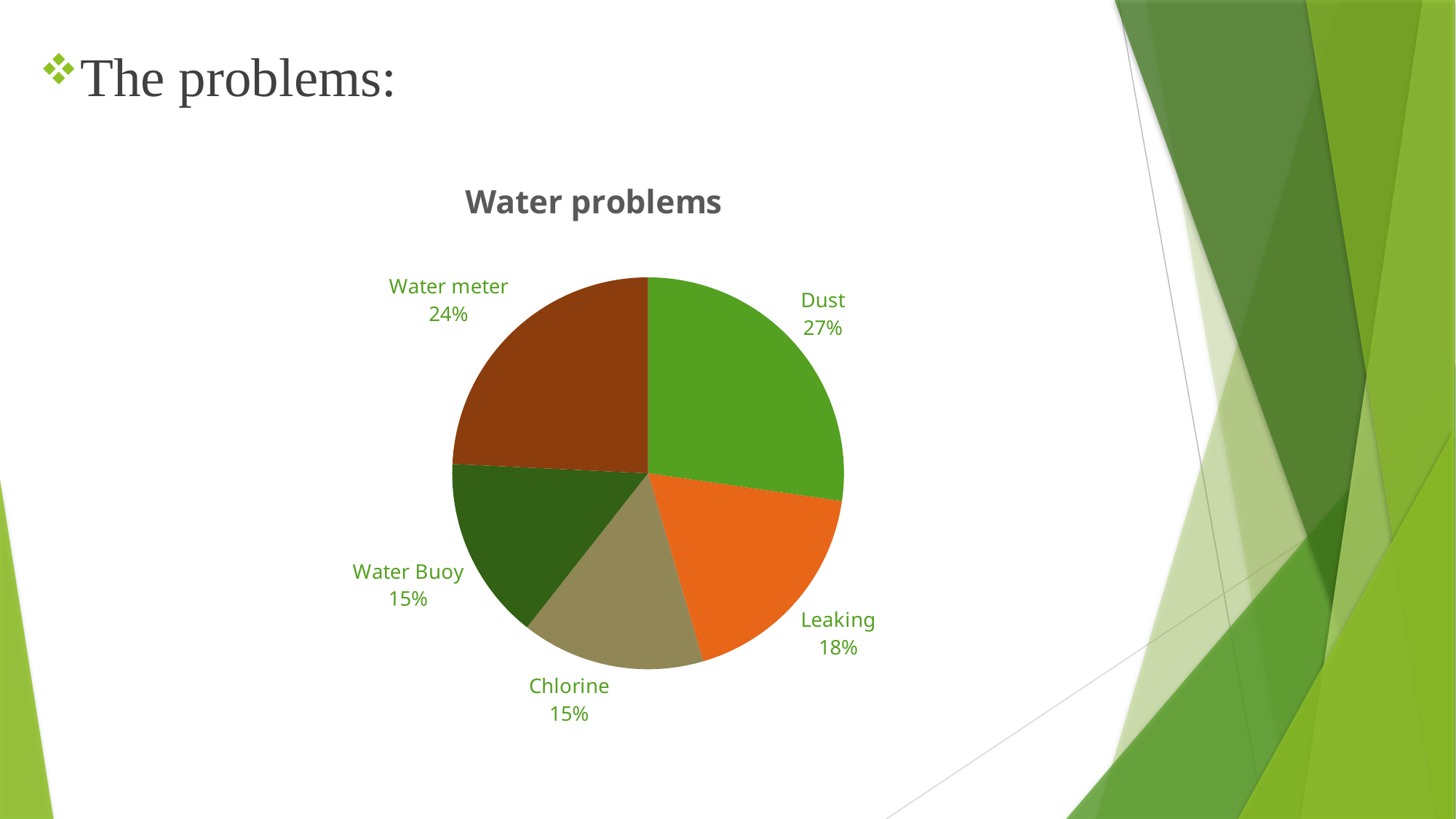
Which category has the largest slice of the pie? Dust What percentage is shown for Leaking? 18% Which is larger, the share for Leaking or the share for Water Buoy? Leaking What is the difference in percentage points between Water meter and Leaking? 6 What kind of chart is shown on the slide? Pie chart What percentage is shown for Water meter? 24% What is the title of the chart? Water problems How many categories are shown in the pie chart? 5 What is the difference in percentage points between Dust and Water meter? 3 What share of the pie does Dust account for? 27% What percentage is shown for Chlorine? 15% What is the combined share of Chlorine and Water Buoy? 30%